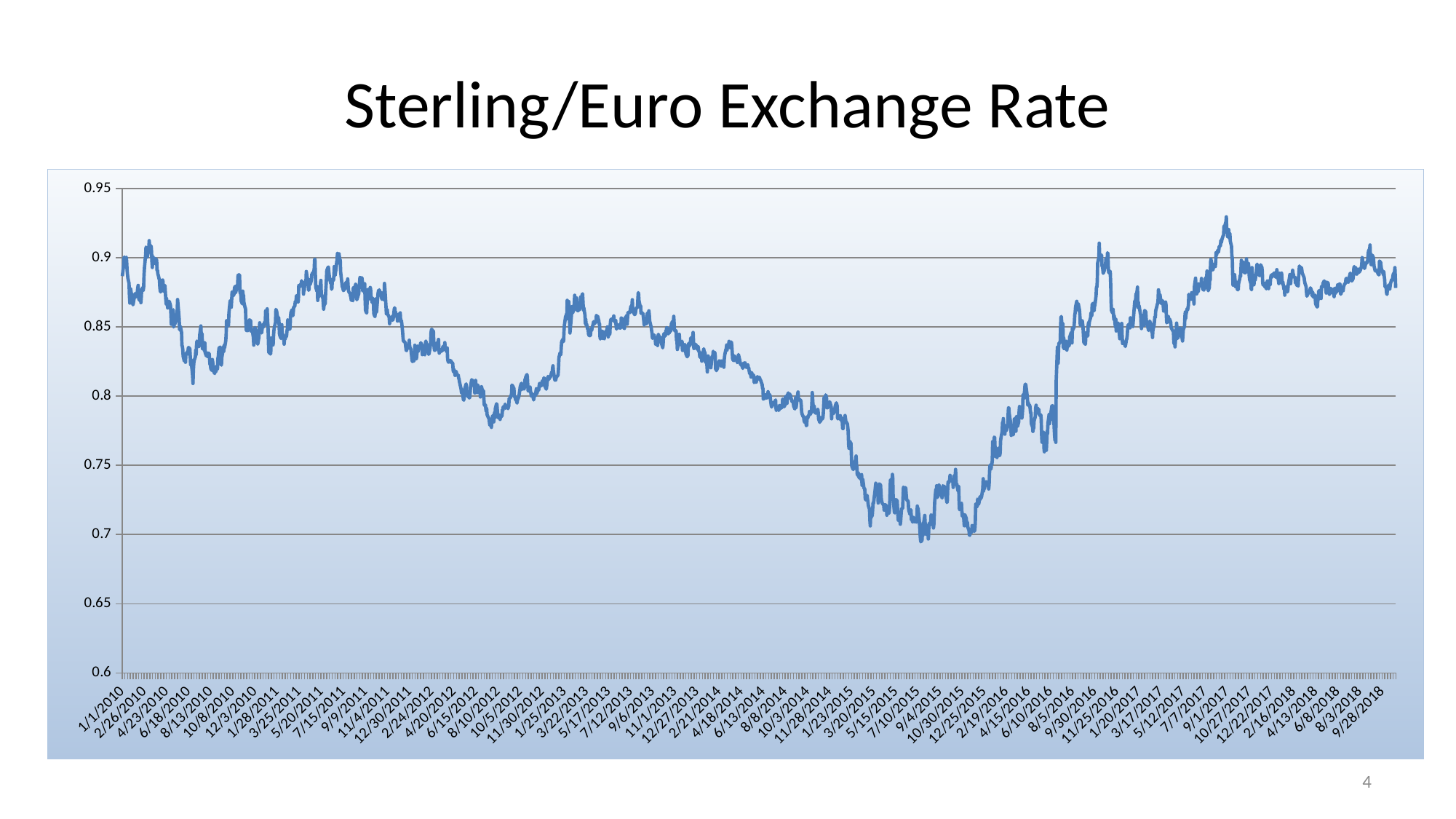
Is the value at 1/1/2010 greater or less than 0.85? greater What kind of chart is shown on the slide? line chart Is the value at 8/10/2012 greater or less than 0.85? less What is the highest value shown on the vertical axis? 0.95 Near which x-axis date label does the line reach its lowest point? 7/10/2015 Is the value at 7/10/2015 greater or less than 0.75? less What is the title of the chart? Sterling/Euro Exchange Rate Between 7/10/2015 and 9/1/2017, do the values overall rise or fall? rise Near which x-axis date label does the line reach its highest point? 9/1/2017 Which is larger, the value at 1/1/2010 or the value at 7/10/2015? 1/1/2010